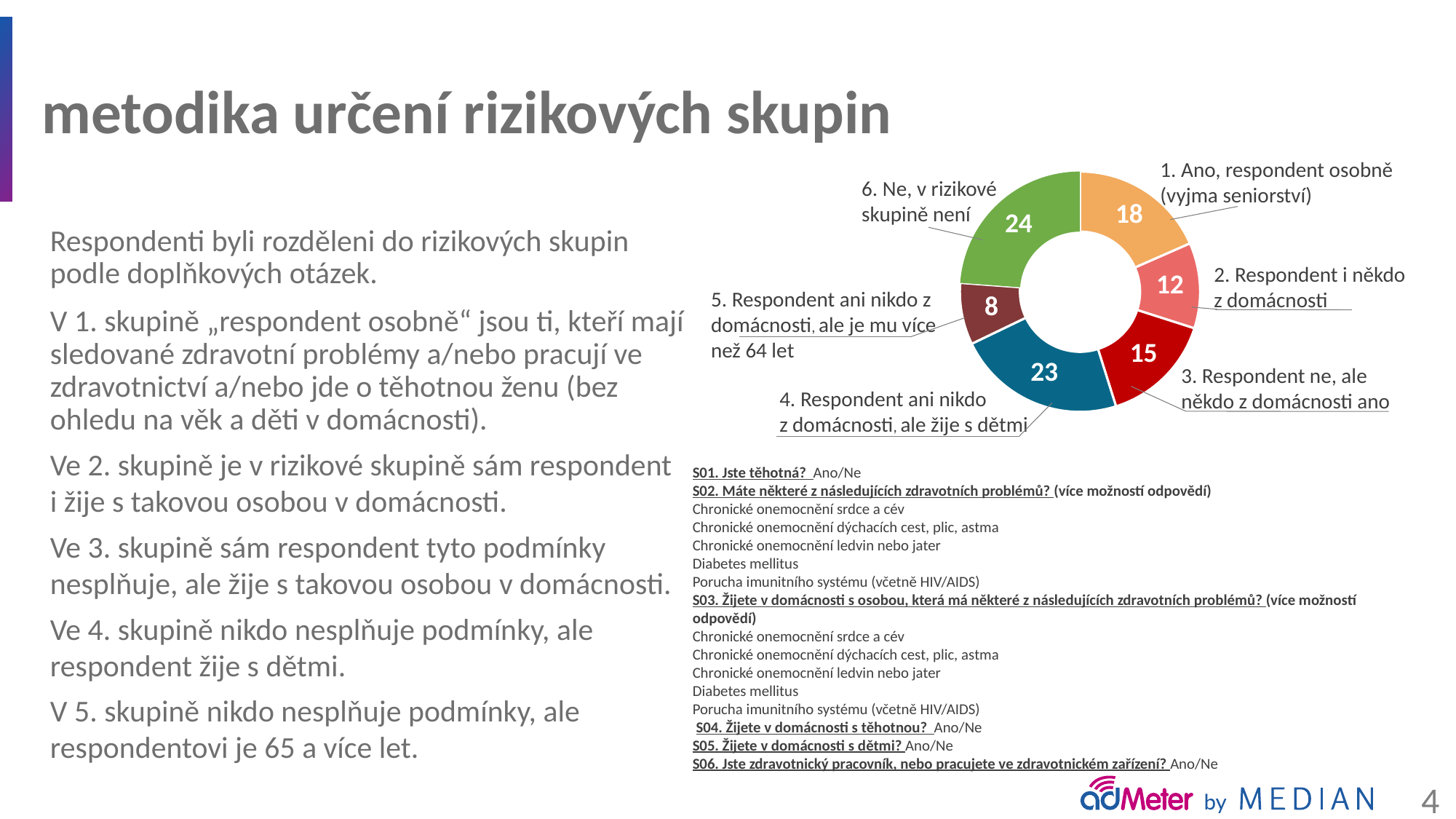
What is the difference between the values for "6. Ne, v rizikové skupině není" and "1. Ano, respondent osobně (vyjma seniorství)"? 6 What type of chart is shown on the slide? Donut (pie) chart Which slice has the largest value? 6. Ne, v rizikové skupině není What is the total of all slice values in the donut chart? 100 What is the value for "3. Respondent ne, ale někdo z domácnosti ano"? 15 What is the value for "2. Respondent i někdo z domácnosti"? 12 What is the value for "4. Respondent ani nikdo z domácnosti, ale žije s dětmi"? 23 Which slice has the smallest value? 5. Respondent ani nikdo z domácnosti, ale je mu více než 64 let What is the value for "5. Respondent ani nikdo z domácnosti, ale je mu více než 64 let"? 8 What is the value for "1. Ano, respondent osobně (vyjma seniorství)"? 18 How many slices does the donut chart have? 6 Which is larger: the value for "4. Respondent ani nikdo z domácnosti, ale žije s dětmi" or for "3. Respondent ne, ale někdo z domácnosti ano"? 4. Respondent ani nikdo z domácnosti, ale žije s dětmi